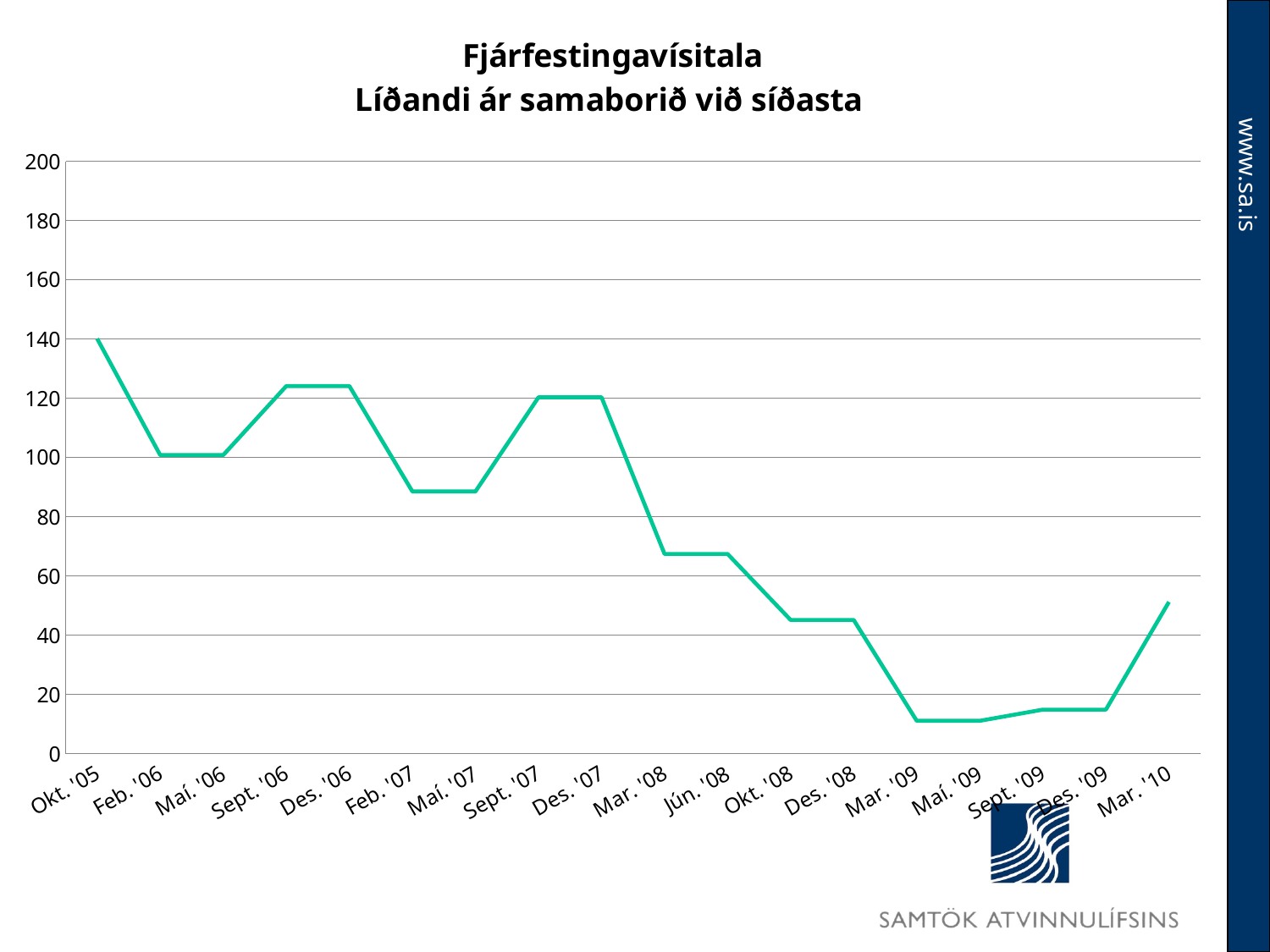
What is the title of the chart? Fjárfestingavísitala Líðandi ár samaborið við síðasta Which time point has the highest value? Okt. '05 Is the value for Mar. '10 greater or less than 40? greater Is the value for Feb. '07 greater or less than 100? less Which is larger, the value for Sept. '06 or the value for Feb. '07? Sept. '06 Overall, do the values rise or fall from Okt. '05 to Mar. '10? fall Is the value for Sept. '06 greater or less than 120? greater How many time points are plotted along the x axis? 18 What kind of chart is shown on the slide? line chart